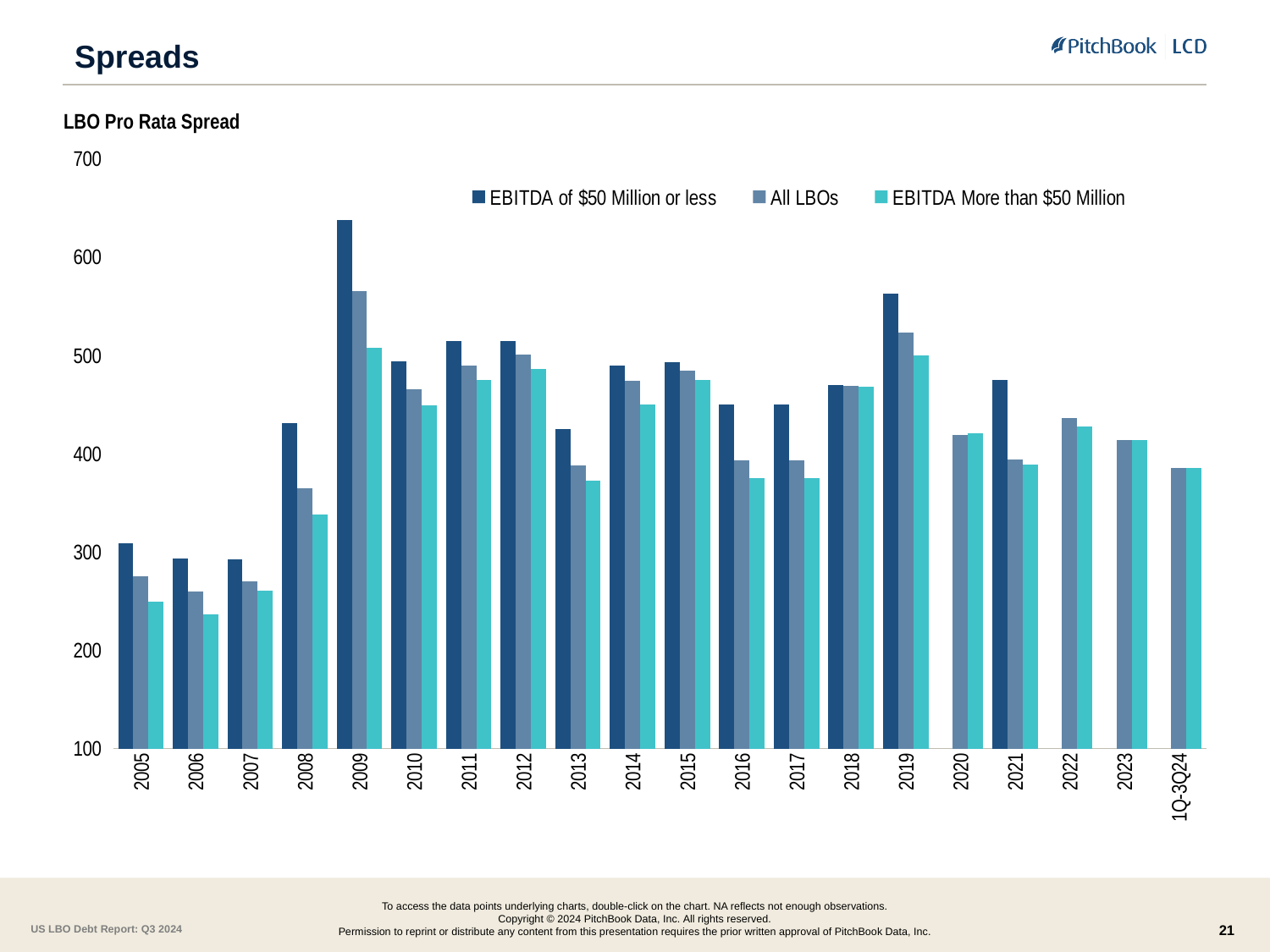
Does the value for EBITDA of $50 Million or less rise or fall from 2007 to 2009? rise Is the value for EBITDA of $50 Million or less in 2009 greater or less than 600? greater How many categories are shown along the x axis? 20 What kind of chart is shown on the slide? bar chart How many series does the legend list? 3 In which year is the value for All LBOs highest? 2009 Which is larger for All LBOs: the value in 2012 or the value in 2013? 2012 Which series is shown in the darkest blue colour? EBITDA of $50 Million or less What is the title of the chart? LBO Pro Rata Spread Is the value for EBITDA More than $50 Million in 2005 greater or less than 300? less Is the value for All LBOs in 1Q-3Q24 greater or less than 400? less In which year is the value for EBITDA of $50 Million or less highest? 2009